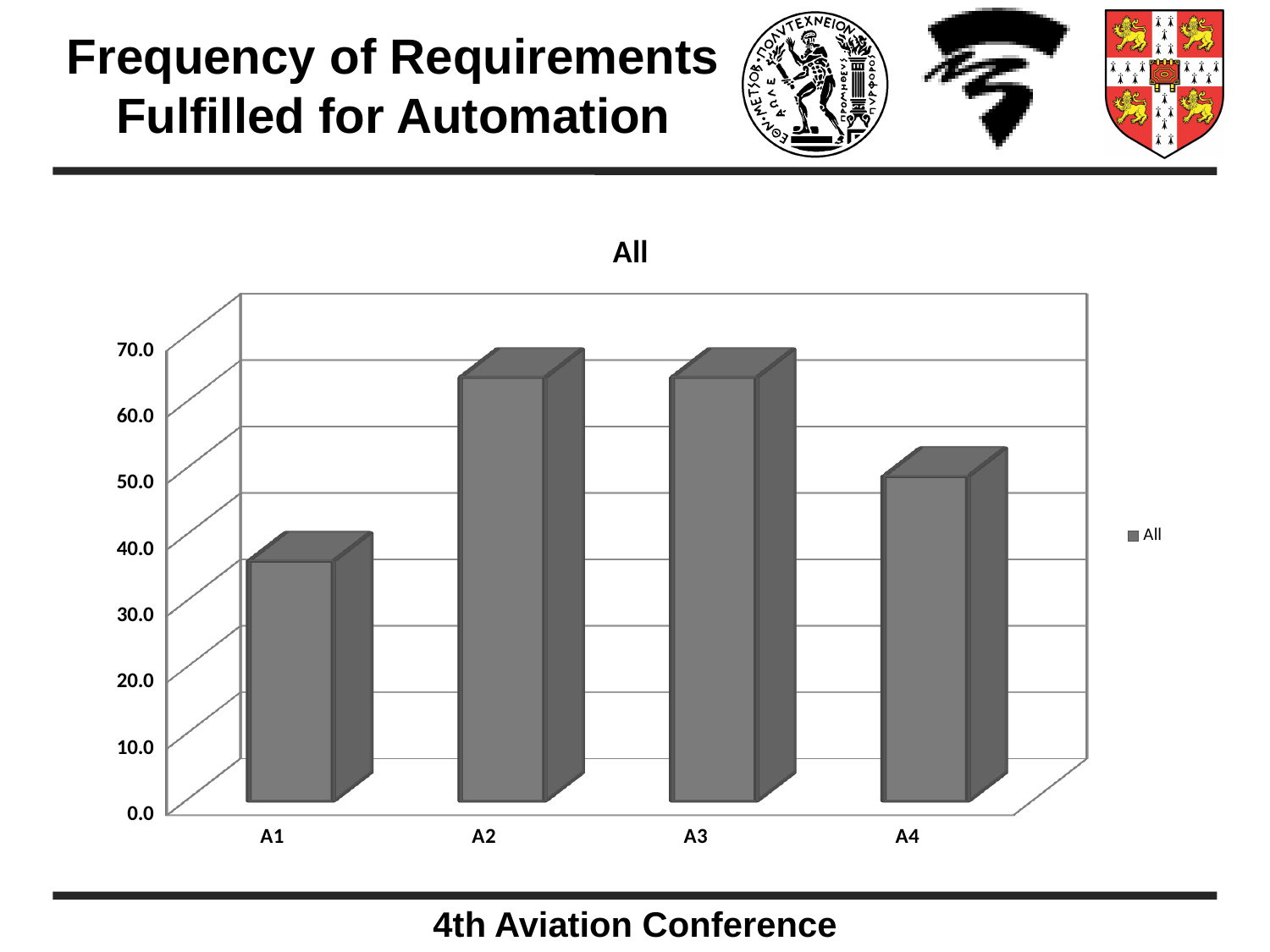
Is the value for A2 greater or less than 60? greater What is the title of the chart? All Which category has the lowest value? A1 Which is larger, the value for A2 or the value for A4? A2 Is the value for A1 greater or less than 50? less How many series does the legend list? 1 What kind of chart is shown on the slide? bar chart Is the value for A4 greater or less than 60? less Which is larger, the value for A4 or the value for A1? A4 How many categories are shown on the x axis of the chart? 4